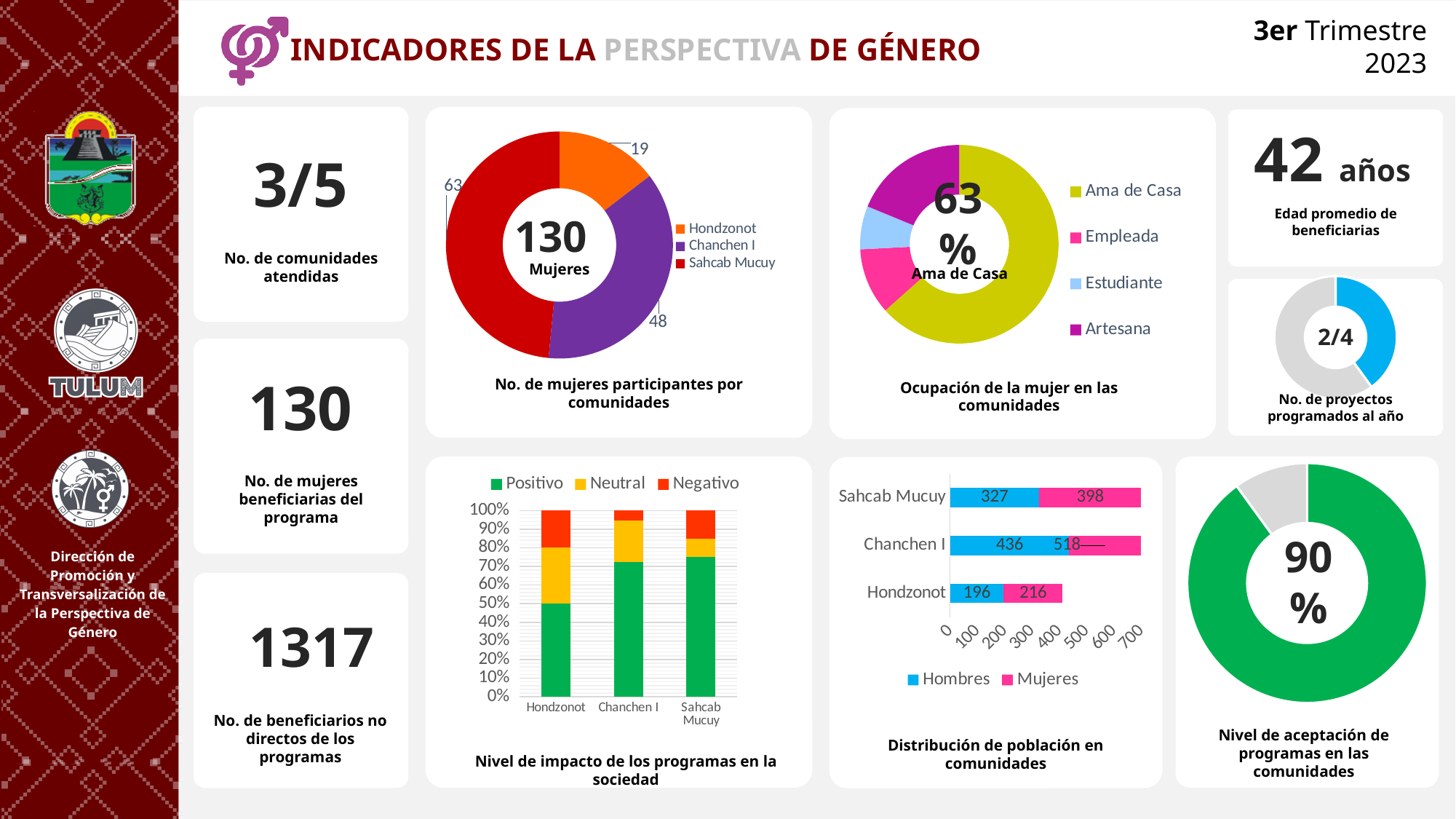
In the chart 'Distribución de población en comunidades', which is larger in Sahcab Mucuy, Hombres or Mujeres? Mujeres In the chart 'No. de mujeres participantes por comunidades', how many women participants are from Chanchen I? 48 In the chart 'Ocupación de la mujer en las comunidades', what percentage is shown for Ama de Casa? 63% In the chart 'No. de mujeres participantes por comunidades', what total is shown in the centre of the donut? 130 Mujeres In the chart 'Distribución de población en comunidades', what is the total population of Hondzonot (Hombres plus Mujeres)? 412 In the chart 'Nivel de impacto de los programas en la sociedad', is the Positivo share for Hondzonot greater or less than 60%? less In the chart 'Distribución de población en comunidades', what is the value for Mujeres in Chanchen I? 518 In the chart 'No. de mujeres participantes por comunidades', what is the difference between Sahcab Mucuy and Hondzonot? 44 In the chart 'No. de mujeres participantes por comunidades', which community has the highest number of women participants? Sahcab Mucuy How many categories does the legend of the chart 'Ocupación de la mujer en las comunidades' list? 4 What kind of chart is 'Nivel de impacto de los programas en la sociedad'? Stacked bar chart In the chart 'No. de mujeres participantes por comunidades', which community has the lowest number of women participants? Hondzonot